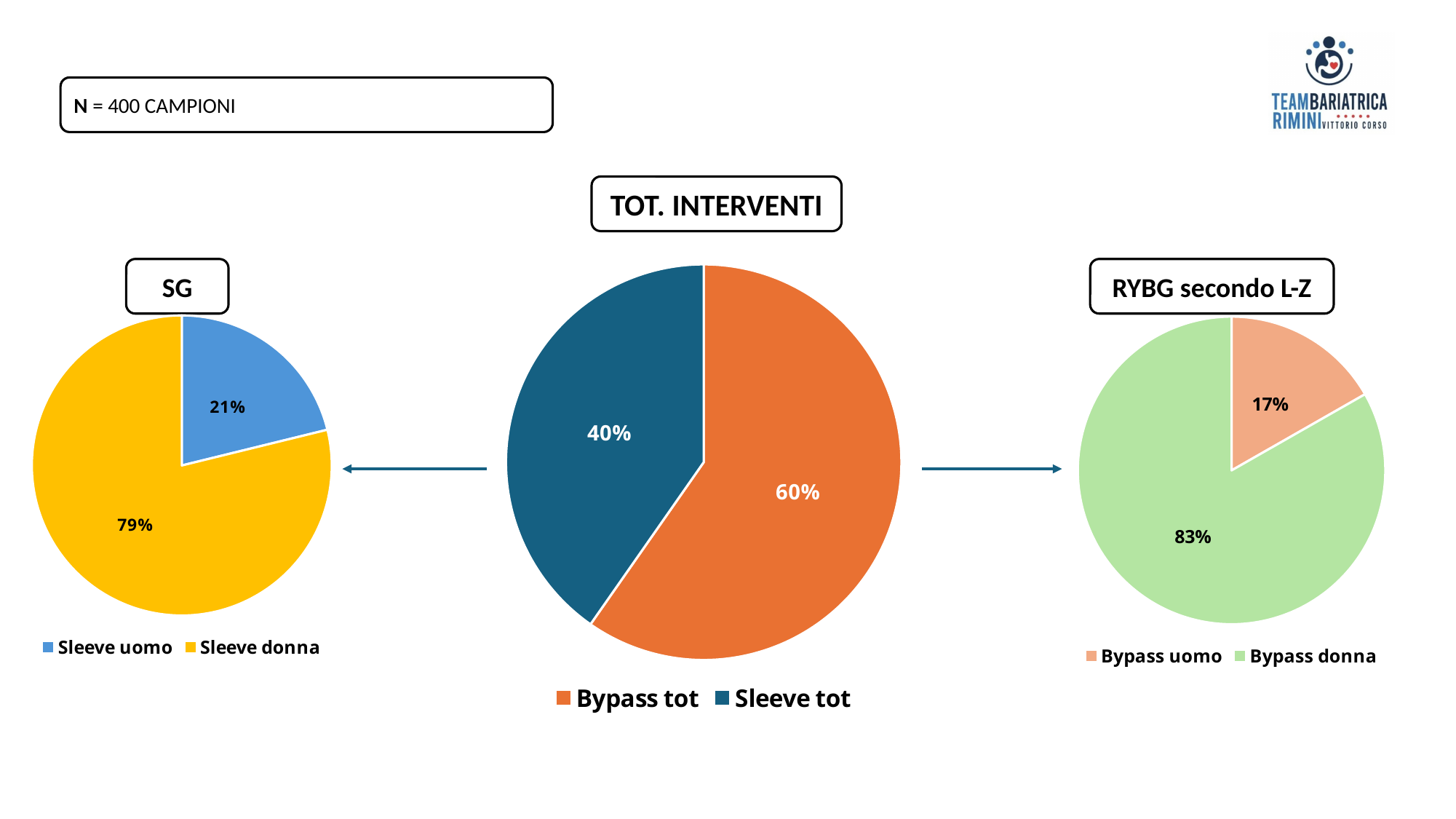
In the TOT. INTERVENTI chart, which slice is larger, Bypass tot or Sleeve tot? Bypass tot What kind of chart is the TOT. INTERVENTI chart? Pie chart In the SG chart, what share is Sleeve uomo? 21% In the SG chart, what is the difference in percentage points between Sleeve donna and Sleeve uomo? 58 How many entries does the legend of the RYBG secondo L-Z chart list? 2 In the RYBG secondo L-Z chart, what share is Bypass donna? 83% In the RYBG secondo L-Z chart, which slice is the smallest? Bypass uomo In the SG chart, which slice is the largest? Sleeve donna In the SG chart, what share is Sleeve donna? 79%